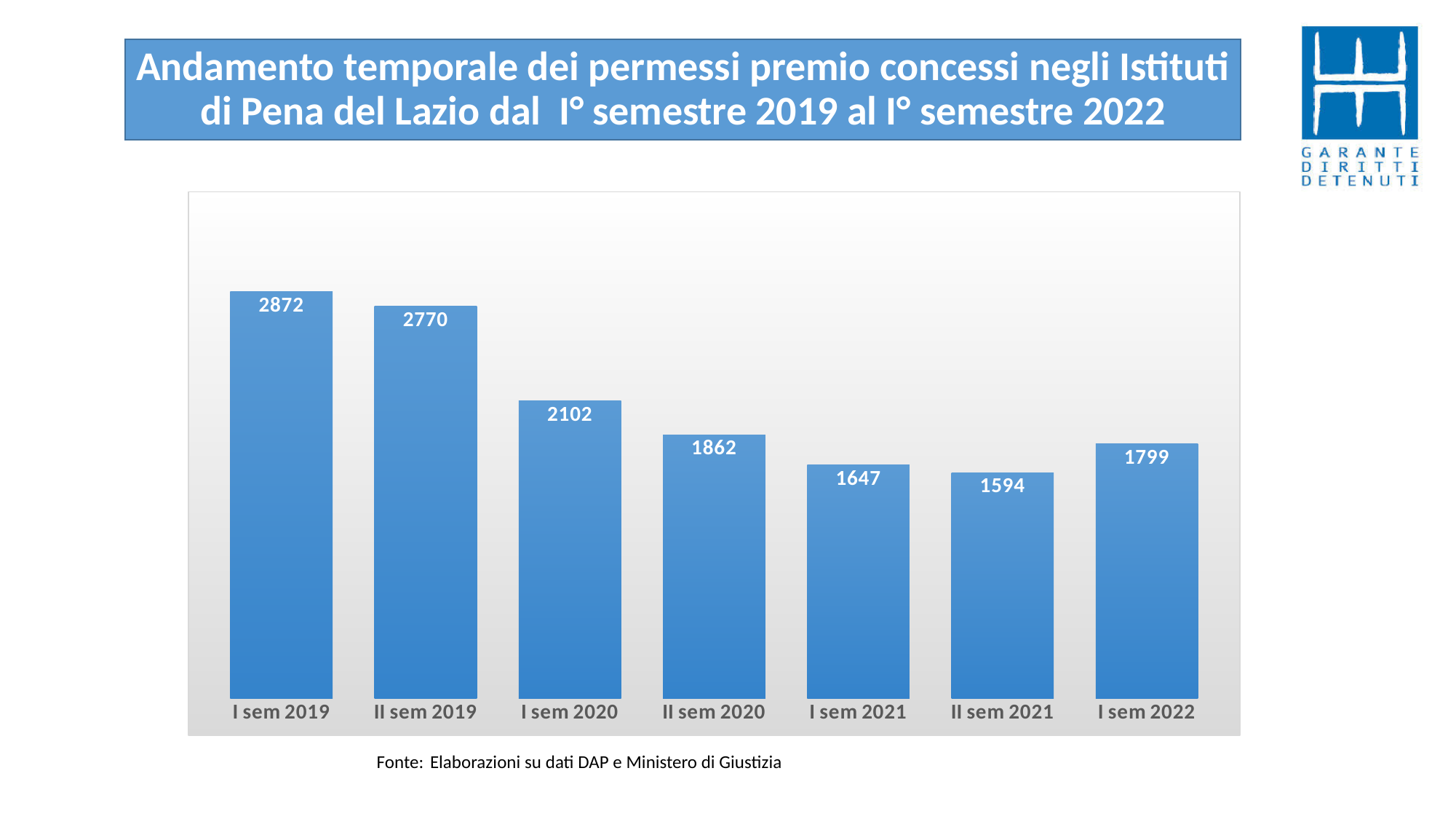
Do the values generally rise or fall from I sem 2019 to II sem 2021? Fall Which is larger, the value for I sem 2021 or the value for I sem 2022? I sem 2022 How many semesters are shown on the chart? 7 What is the value for I sem 2022? 1799 What is the value for I sem 2019? 2872 What kind of chart is shown on the slide? Bar chart What is the difference between the values for I sem 2020 and II sem 2020? 240 Which semester has the highest value? I sem 2019 What is the value for II sem 2020? 1862 Which semester has the lowest value? II sem 2021 What source is cited below the chart? Elaborazioni su dati DAP e Ministero di Giustizia What is the difference between the values for I sem 2019 and II sem 2019? 102